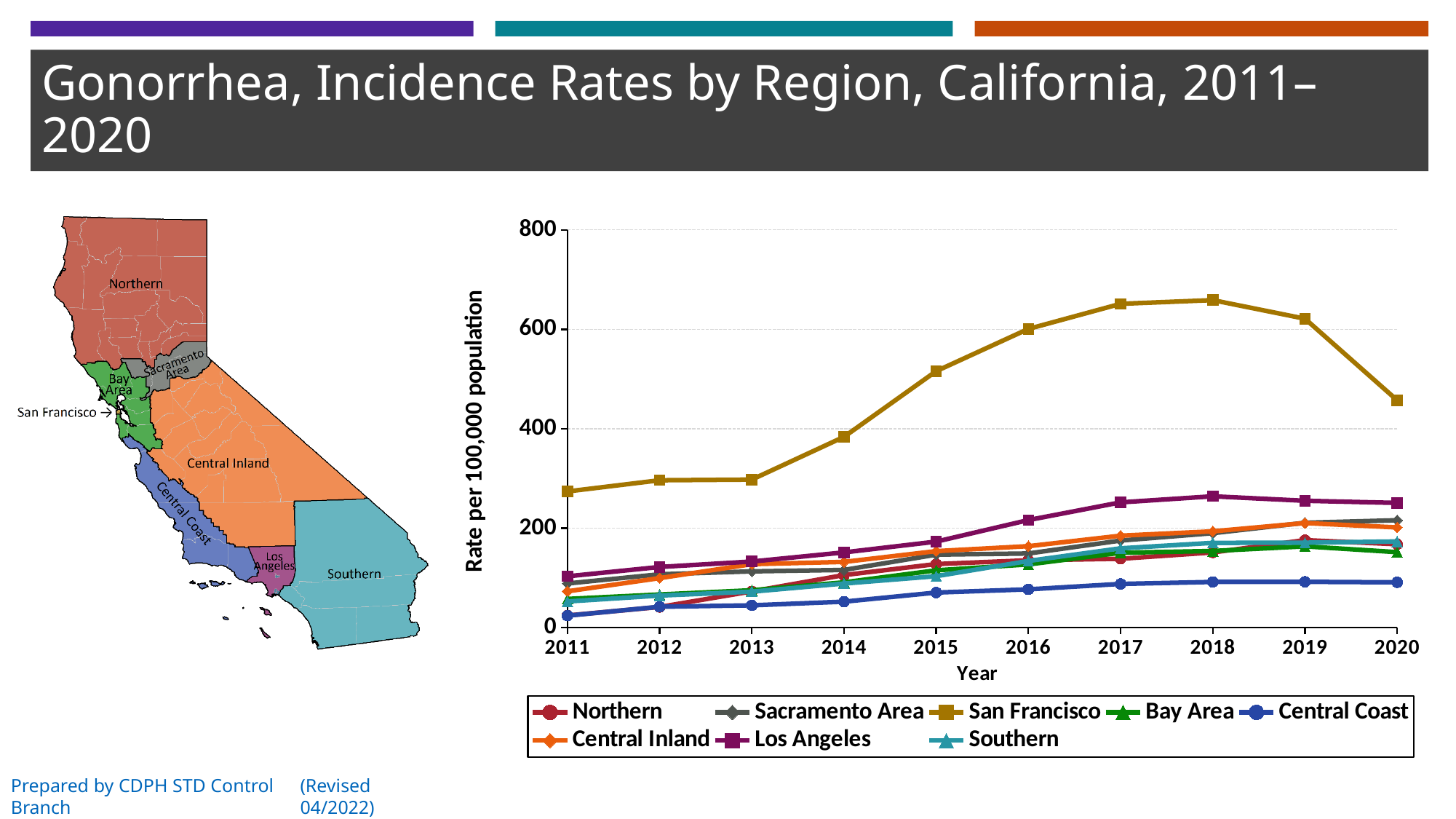
What is the label on the chart's y axis? Rate per 100,000 population How many regions does the chart's legend list? 8 Does the San Francisco rate rise or fall from 2018 to 2020? fall Is the value for Central Coast in 2020 greater or less than 200? less What kind of chart is shown on the slide? line chart Which region has the highest gonorrhea incidence rate in 2018? San Francisco How many years are plotted along the x axis of the chart? 10 In 2020, which is larger: the rate for Los Angeles or the rate for Central Coast? Los Angeles Is the value for San Francisco in 2011 greater or less than 400? less Is the value for San Francisco in 2018 greater or less than 600? greater